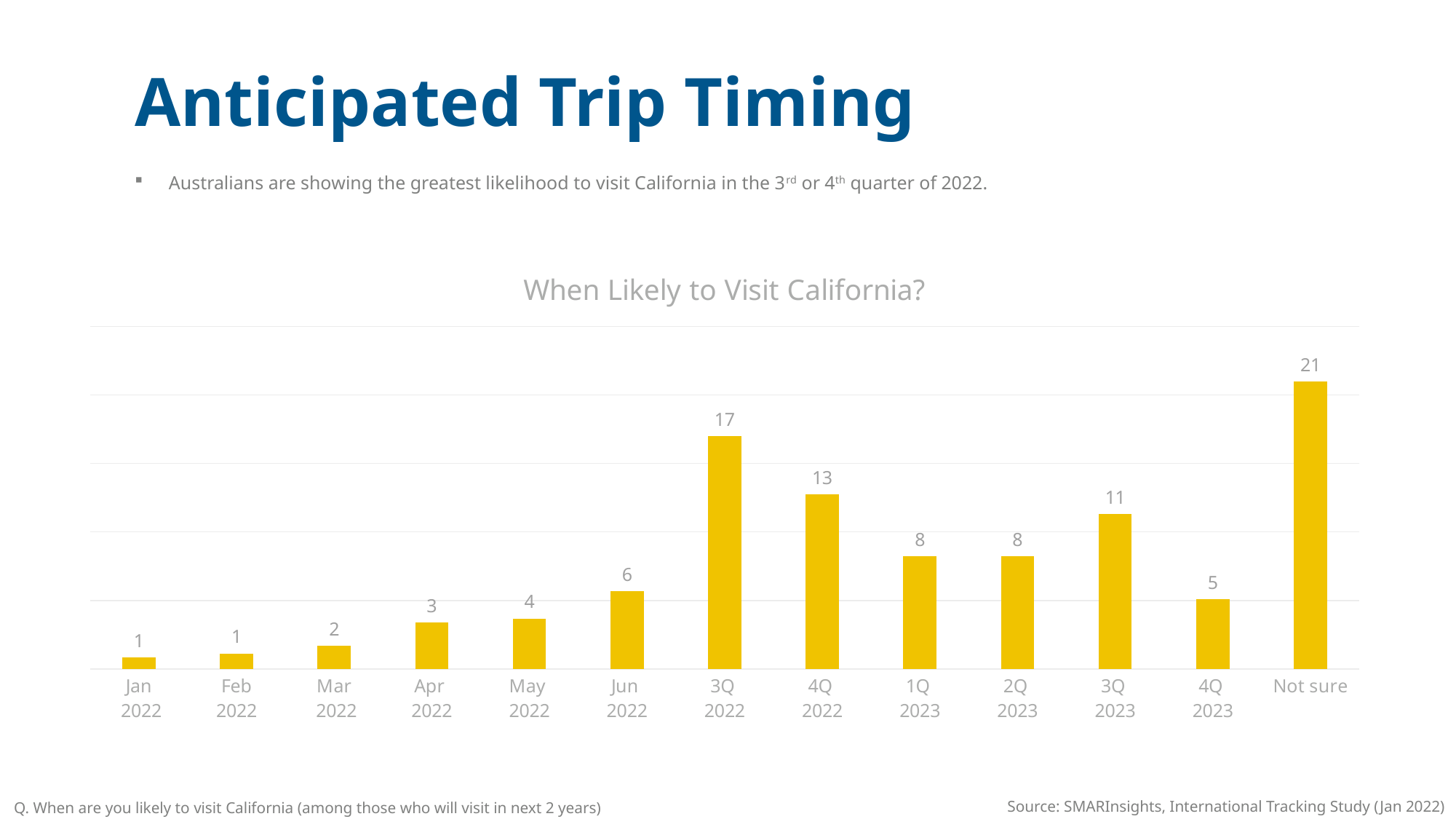
What is the total of the values for 1Q 2023 and 2Q 2023? 16 What is the value for Jun 2022? 6 Which quarter of 2023 has the highest value? 3Q 2023 What is the value for 3Q 2022? 17 Which is larger, the value for 4Q 2022 or the value for 3Q 2023? 4Q 2022 Do the values rise or fall from Jan 2022 to Jun 2022? Rise What is the title of the chart? When Likely to Visit California? What kind of chart is this? Bar chart What is the difference between the values for 3Q 2022 and 4Q 2022? 4 How many categories are shown on the x axis? 13 What is the value for Not sure? 21 Which category has the highest value? Not sure